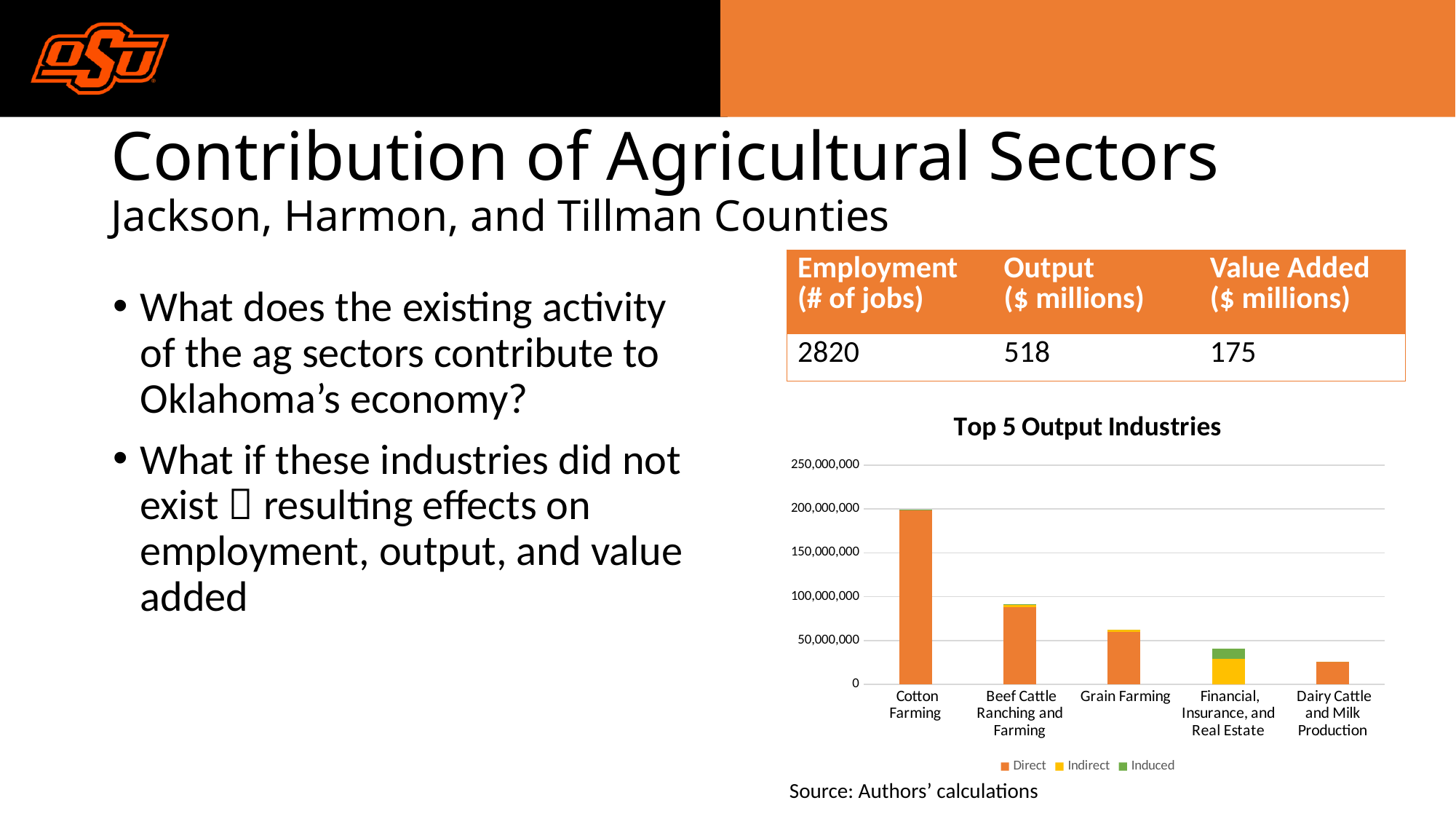
Which industry has the highest total bar in the Top 5 Output Industries chart? Cotton Farming What is the title of the chart on the slide? Top 5 Output Industries Which industry has the lowest total bar in the Top 5 Output Industries chart? Dairy Cattle and Milk Production In the Top 5 Output Industries chart, is the total bar for Cotton Farming greater or less than 150,000,000? greater What kind of chart is the Top 5 Output Industries chart? Stacked bar chart Which series in the Top 5 Output Industries chart is shown in green? Induced How many series does the legend of the Top 5 Output Industries chart list? 3 Do the total bar heights rise or fall from left to right across the Top 5 Output Industries chart? Fall How many industries are shown on the x axis of the Top 5 Output Industries chart? 5 In the Top 5 Output Industries chart, is the total bar for Dairy Cattle and Milk Production greater or less than 50,000,000? less In the Top 5 Output Industries chart, is the total bar for Grain Farming greater or less than 100,000,000? less In the Top 5 Output Industries chart, which has the larger total bar: Beef Cattle Ranching and Farming or Grain Farming? Beef Cattle Ranching and Farming